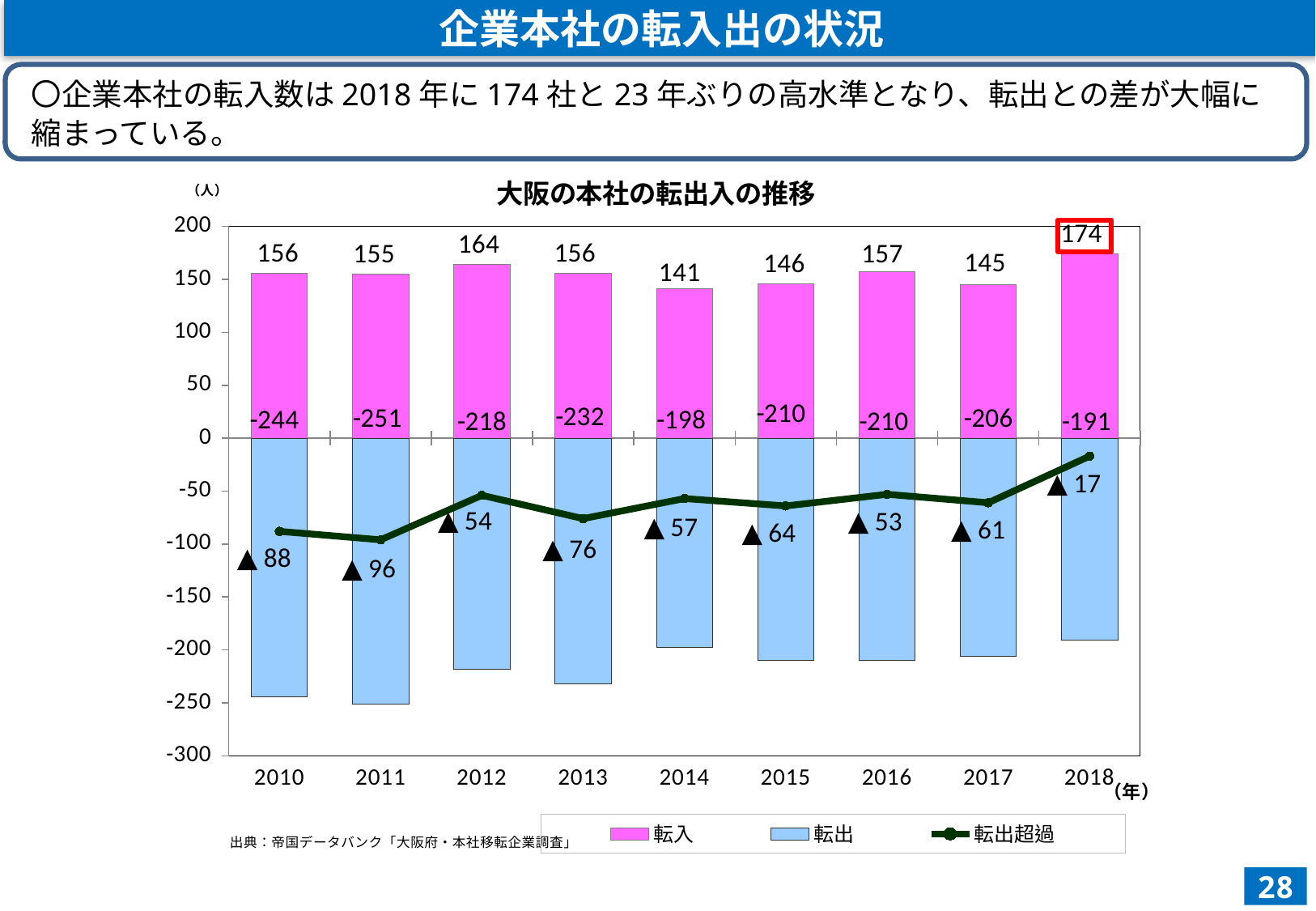
What is the difference between the 転入 values for 2018 and 2017? 29 How many years are shown on the x axis? 9 Which year has the highest 転入 value? 2018 What is the value of 転入 for 2018? 174 What is the value of 転出 for 2011? -251 What kind of chart is this? Combined bar and line chart Which year has the lowest 転入 value? 2014 What is the 転出超過 value shown for 2013? ▲76 What is the title of the chart? 大阪の本社の転出入の推移 Which is larger, the 転入 value for 2012 or for 2016? 2012 How many series does the legend list? 3 Does the 転出超過 line rise or fall from 2017 to 2018? Rise